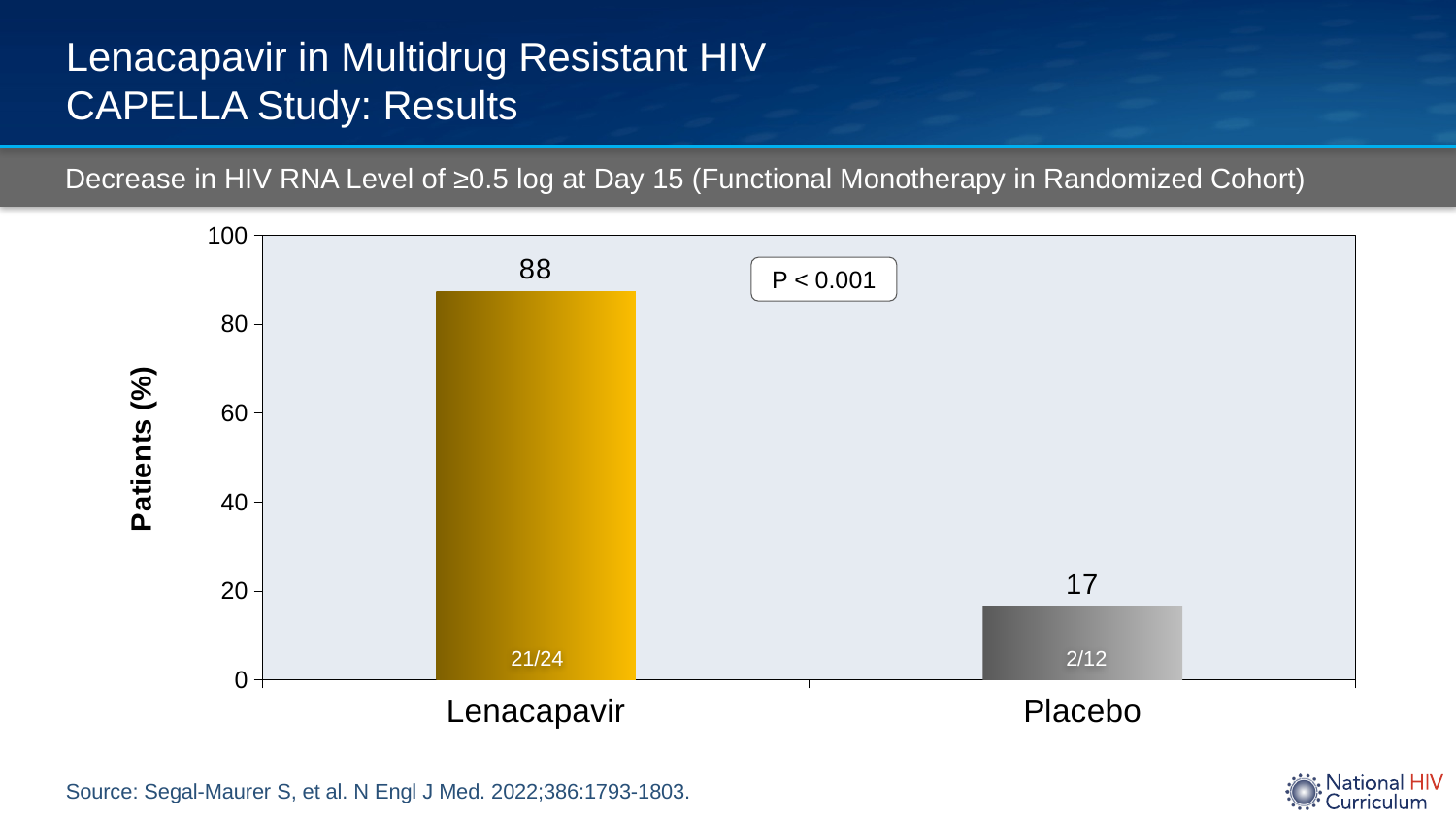
Which category has the lowest value? Placebo What is the y-axis label of the chart? Patients (%) What kind of chart is shown? bar chart What is the value for Placebo? 17 What is the difference between the Lenacapavir and Placebo values? 71 What is the value for Lenacapavir? 88 What fraction of patients is printed inside the Lenacapavir bar? 21/24 Which is larger, the value for Lenacapavir or the value for Placebo? Lenacapavir Is the value for Placebo greater or less than 20? less How many categories are shown on the x axis? 2 Which category has the highest value? Lenacapavir What fraction of patients is printed inside the Placebo bar? 2/12